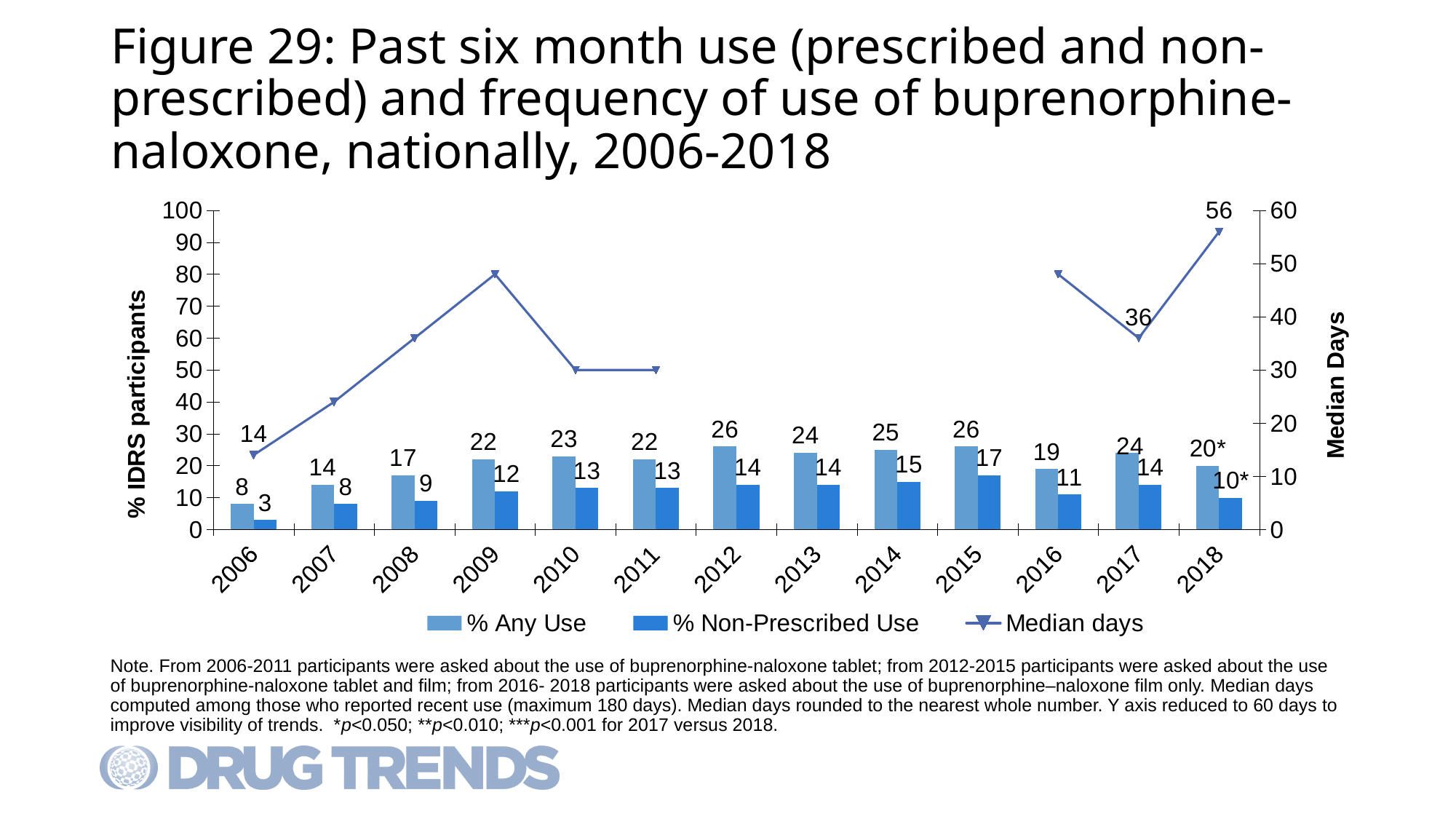
Which year has the higher % Any Use value, 2010 or 2011? 2010 How many series does the legend list? 3 In which year is % Any Use lowest? 2006 How many years are shown on the x axis? 13 What is the % Non-Prescribed Use value for 2015? 17 Is the Median days value for 2009 greater or less than 40? greater What is the Median days value for 2018? 56 What is the Median days value for 2017? 36 What is the % Any Use value for 2012? 26 In which year is % Non-Prescribed Use highest? 2015 What kind of chart is this? Combined bar and line chart What is the difference between % Any Use and % Non-Prescribed Use in 2015? 9